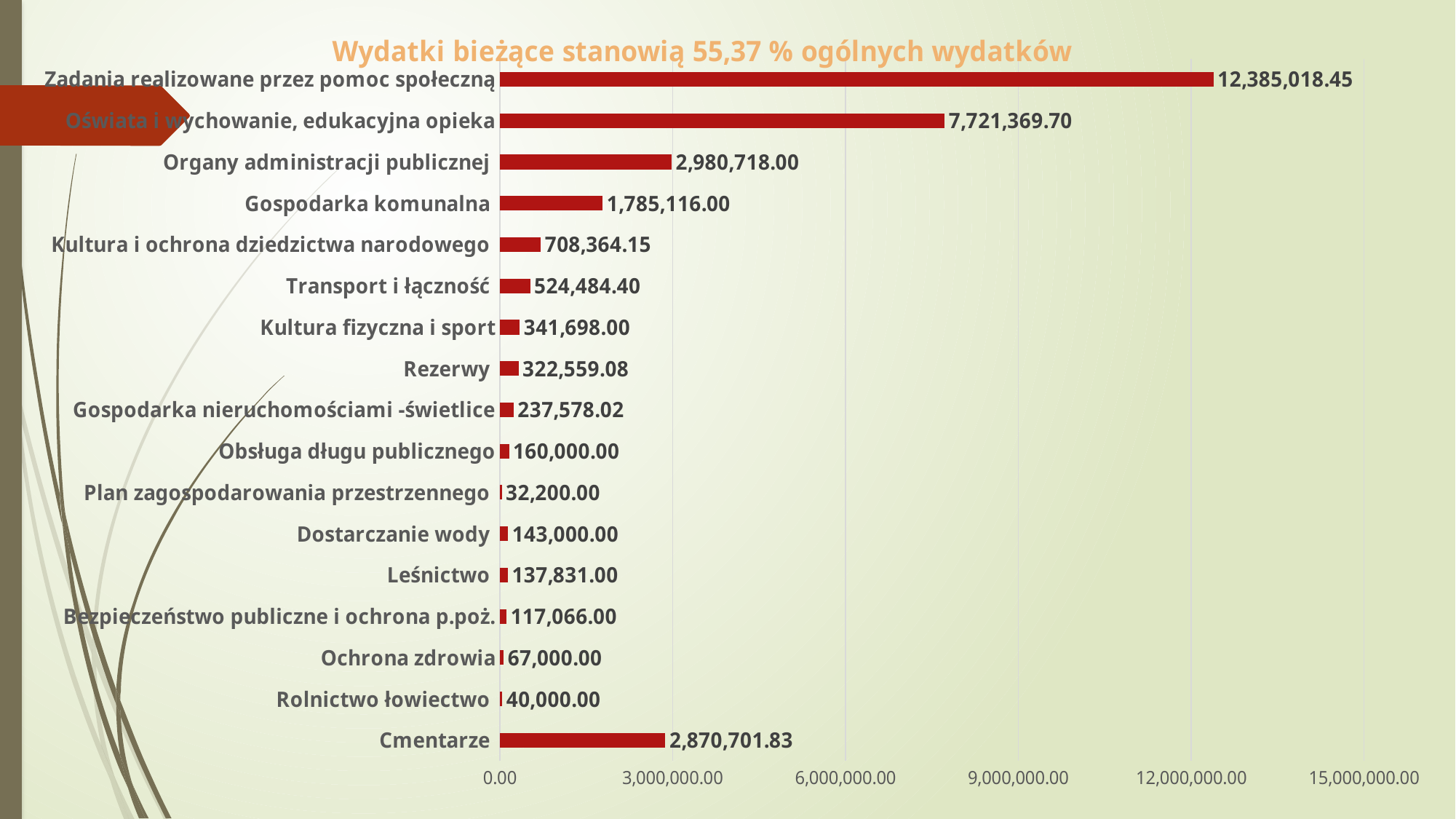
What is the value for Cmentarze? 2,870,701.83 Which category has the highest value? Zadania realizowane przez pomoc społeczną What is the difference between the values for Zadania realizowane przez pomoc społeczną and Oświata i wychowanie, edukacyjna opieka? 4,663,648.75 Which is larger, the value for Gospodarka komunalna or the value for Cmentarze? Cmentarze What is the value for Oświata i wychowanie, edukacyjna opieka? 7,721,369.70 What is the difference between the values for Organy administracji publicznej and Cmentarze? 110,016.17 What is the value for Kultura i ochrona dziedzictwa narodowego? 708,364.15 What is the title of the chart? Wydatki bieżące stanowią 55,37 % ogólnych wydatków What kind of chart is shown on the slide? bar chart Which category has the lowest value? Plan zagospodarowania przestrzennego Is the value for Oświata i wychowanie, edukacyjna opieka greater or less than 6,000,000.00? greater How many categories are shown in the chart? 17